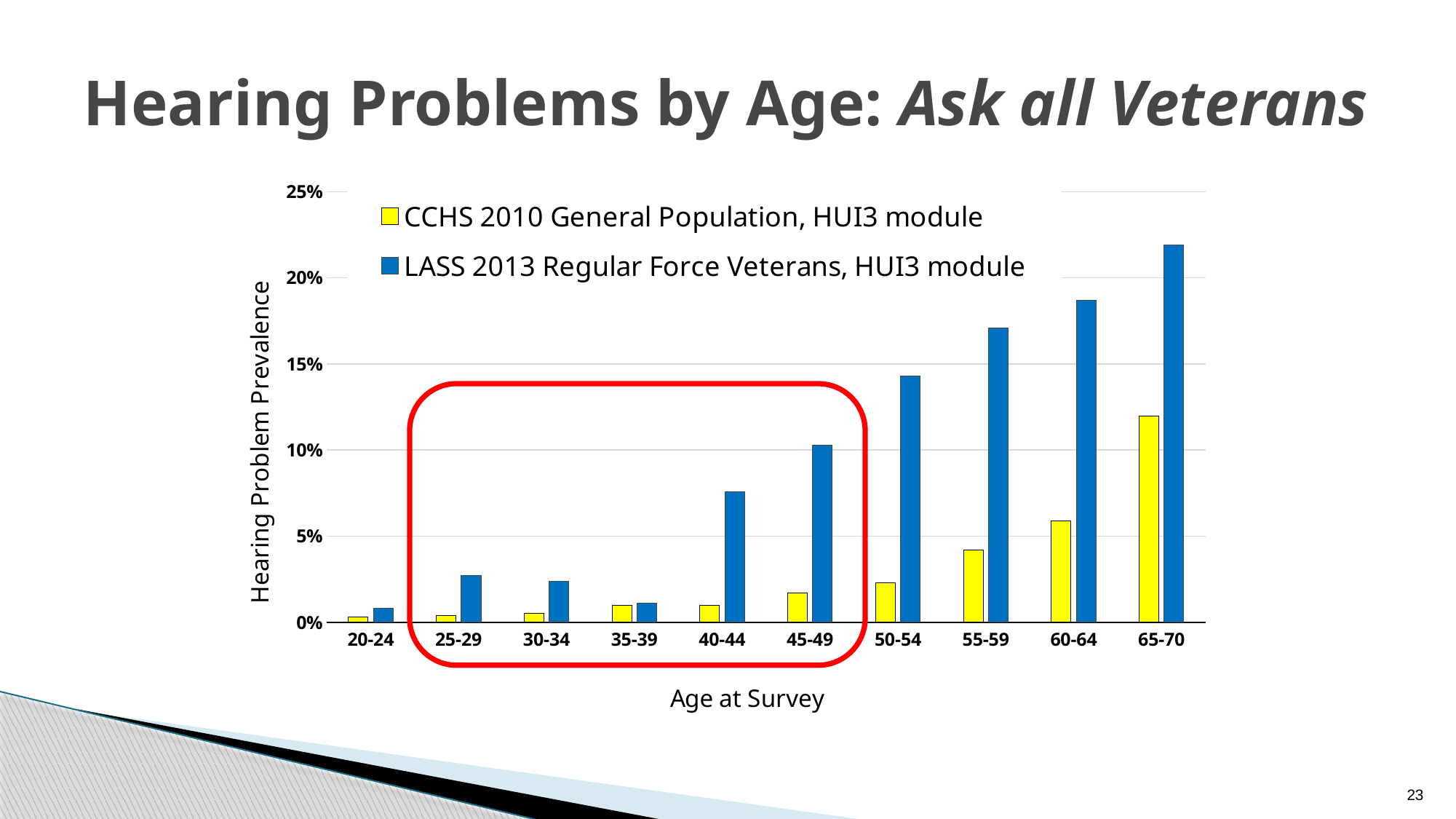
Which age group has the highest value for CCHS 2010 General Population, HUI3 module? 65-70 Is the value for LASS 2013 Regular Force Veterans in the 55-59 age group greater or less than 15%? greater In the 65-70 age group, which series has the larger value: CCHS 2010 General Population or LASS 2013 Regular Force Veterans? LASS 2013 Regular Force Veterans Do the values for LASS 2013 Regular Force Veterans generally rise or fall as age increases along the x axis? Rise Is the value for CCHS 2010 General Population in the 65-70 age group greater or less than 10%? greater Is the value for LASS 2013 Regular Force Veterans in the 65-70 age group greater or less than 20%? greater How many age groups are shown on the x axis? 10 Which age group has the highest value for LASS 2013 Regular Force Veterans, HUI3 module? 65-70 How many series does the legend list? 2 Which age group has the lowest value for LASS 2013 Regular Force Veterans, HUI3 module? 20-24 What kind of chart is shown on the slide? Bar chart